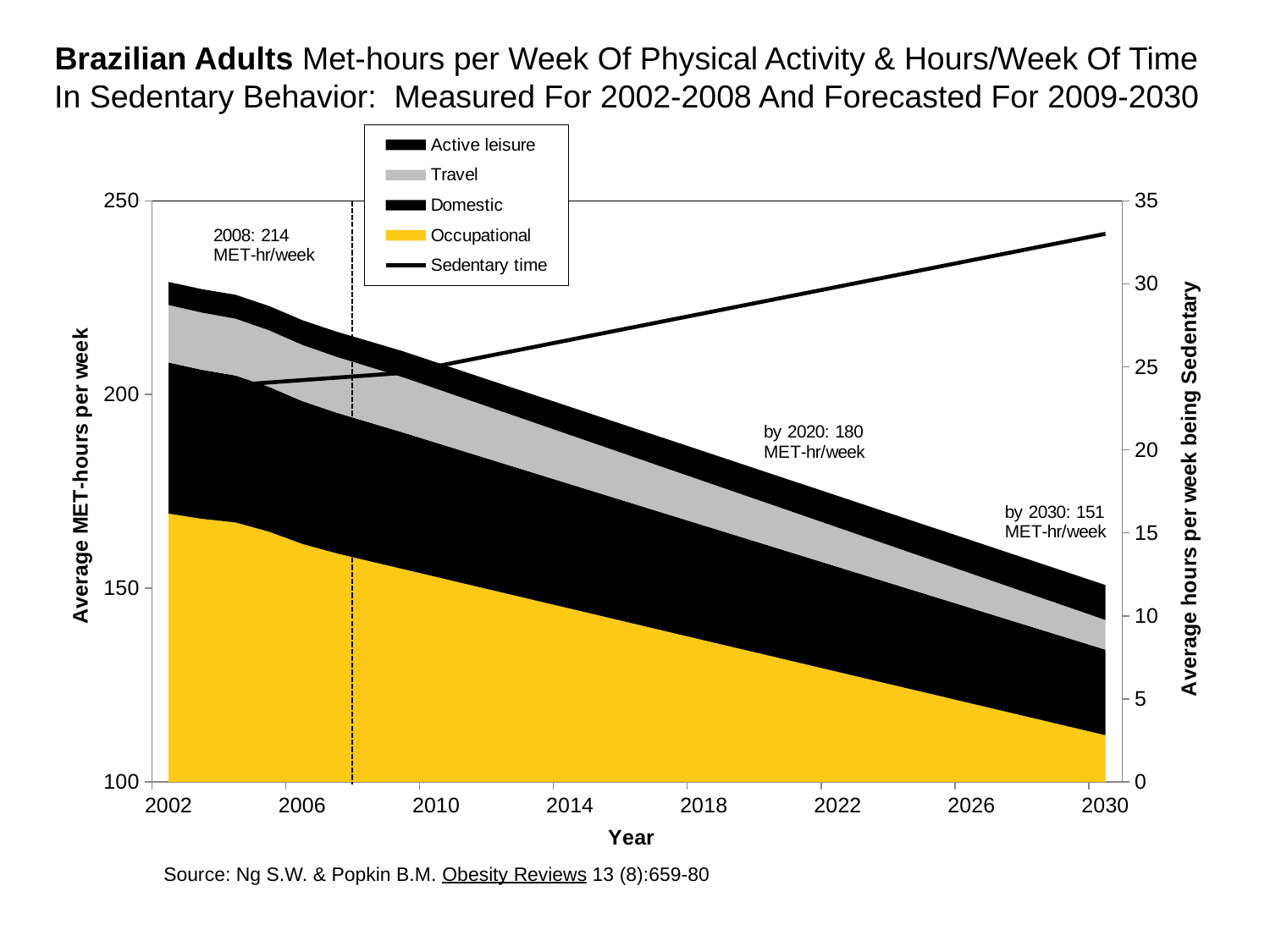
Which series is shown in yellow in the legend? Occupational How many series does the legend list? 5 What is the total average MET-hours per week of physical activity for Brazilian adults in 2008, as labeled on the chart? 214 MET-hr/week What total MET-hours per week is forecast for 2030, according to the chart annotation? 151 MET-hr/week What is the difference between the labeled totals for 2020 and 2030? 29 MET-hr/week Does the sedentary time line rise or fall from 2005 to 2030? Rise What kind of chart is shown on the slide? Stacked area chart with a line for sedentary time Which labeled year has the higher total MET-hours per week, 2008 or 2020? 2008 Does the total MET-hours per week of physical activity rise or fall from 2002 to 2030? Fall What total MET-hours per week is forecast for 2020, according to the chart annotation? 180 MET-hr/week By how many MET-hr/week is the labeled total for 2030 lower than the labeled total for 2008? 63 MET-hr/week Is the sedentary time value in 2030 greater or less than 30 hours per week? greater